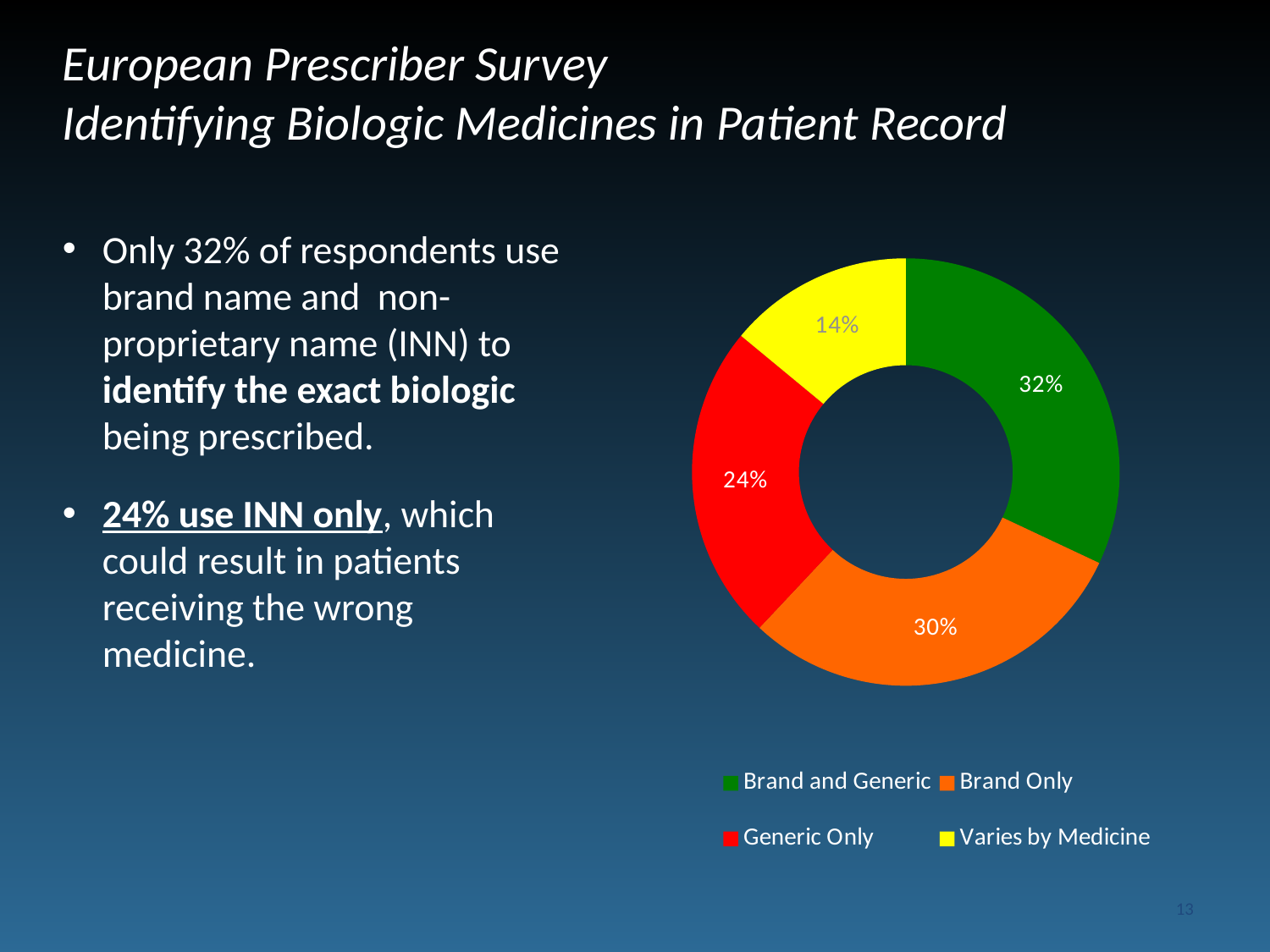
What kind of chart is shown on the slide? Doughnut chart Which is larger, the share for Brand Only or the share for Generic Only? Brand Only Which category has the largest share of the chart? Brand and Generic What percentage of respondents use Brand Only? 30% What percentage of respondents use Generic Only? 24% What colour represents Generic Only in the chart? Red Which category has the smallest share of the chart? Varies by Medicine What is the difference in percentage points between Brand Only and Varies by Medicine? 16 What percentage of respondents use Brand and Generic? 32% What percentage of respondents answered Varies by Medicine? 14% What is the difference in percentage points between Brand and Generic and Generic Only? 8 How many categories are shown in the chart? 4